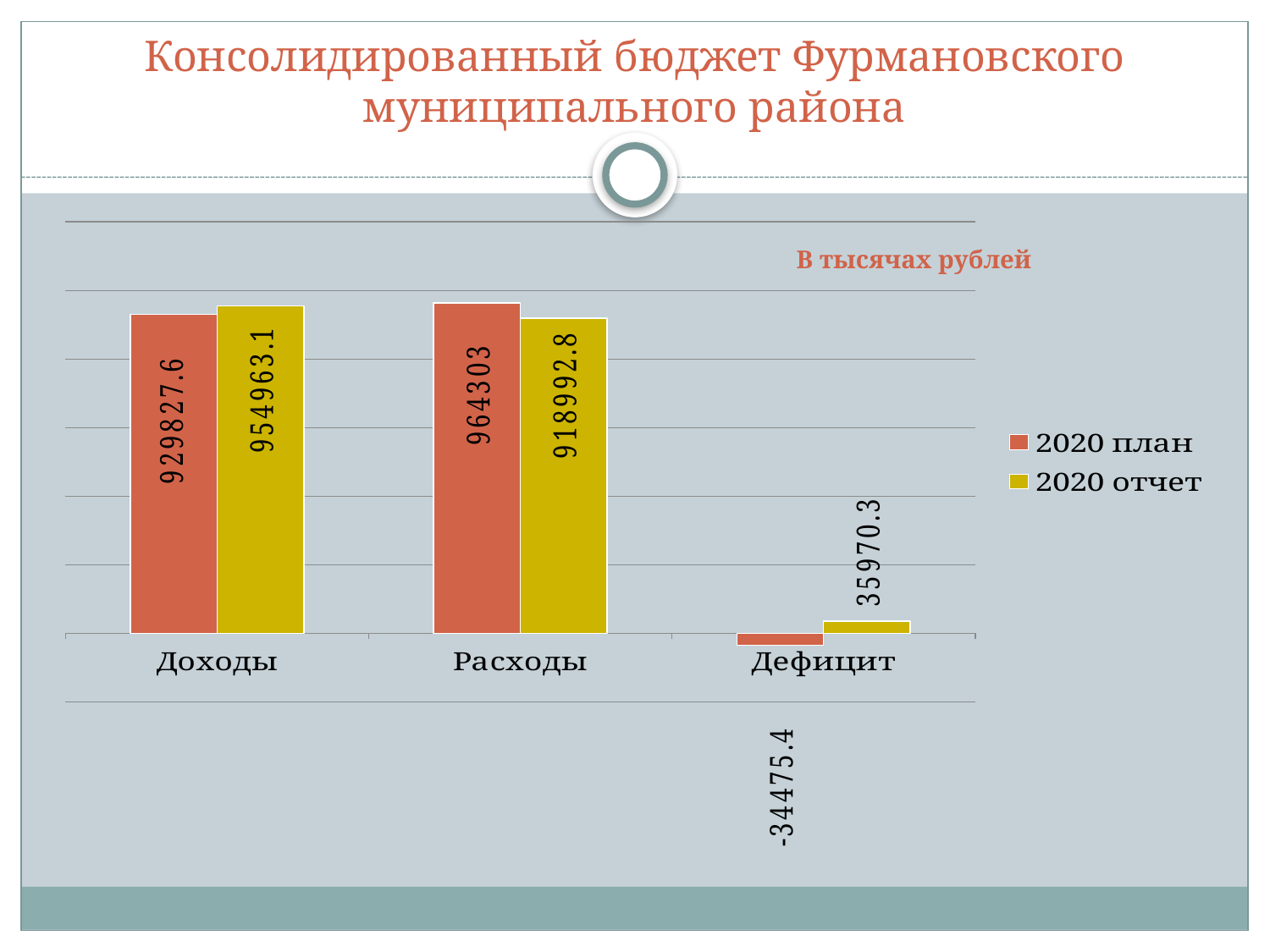
What is the value for Расходы in the 2020 план series? 964303 What is the value for Дефицит in the 2020 отчет series? 35970.3 What is the value for Дефицит in the 2020 план series? -34475.4 What is the value for Доходы in the 2020 отчет series? 954963.1 Which is larger for Расходы: the 2020 план value or the 2020 отчет value? 2020 план How many categories are shown on the x axis? 3 What is the value for Доходы in the 2020 план series? 929827.6 What is the difference between the 2020 отчет and 2020 план values for Доходы? 25135.5 What is the value for Расходы in the 2020 отчет series? 918992.8 Which category has the lowest value in the 2020 отчет series? Дефицит How many series does the legend list? 2 Which category has the highest value in the 2020 план series? Расходы